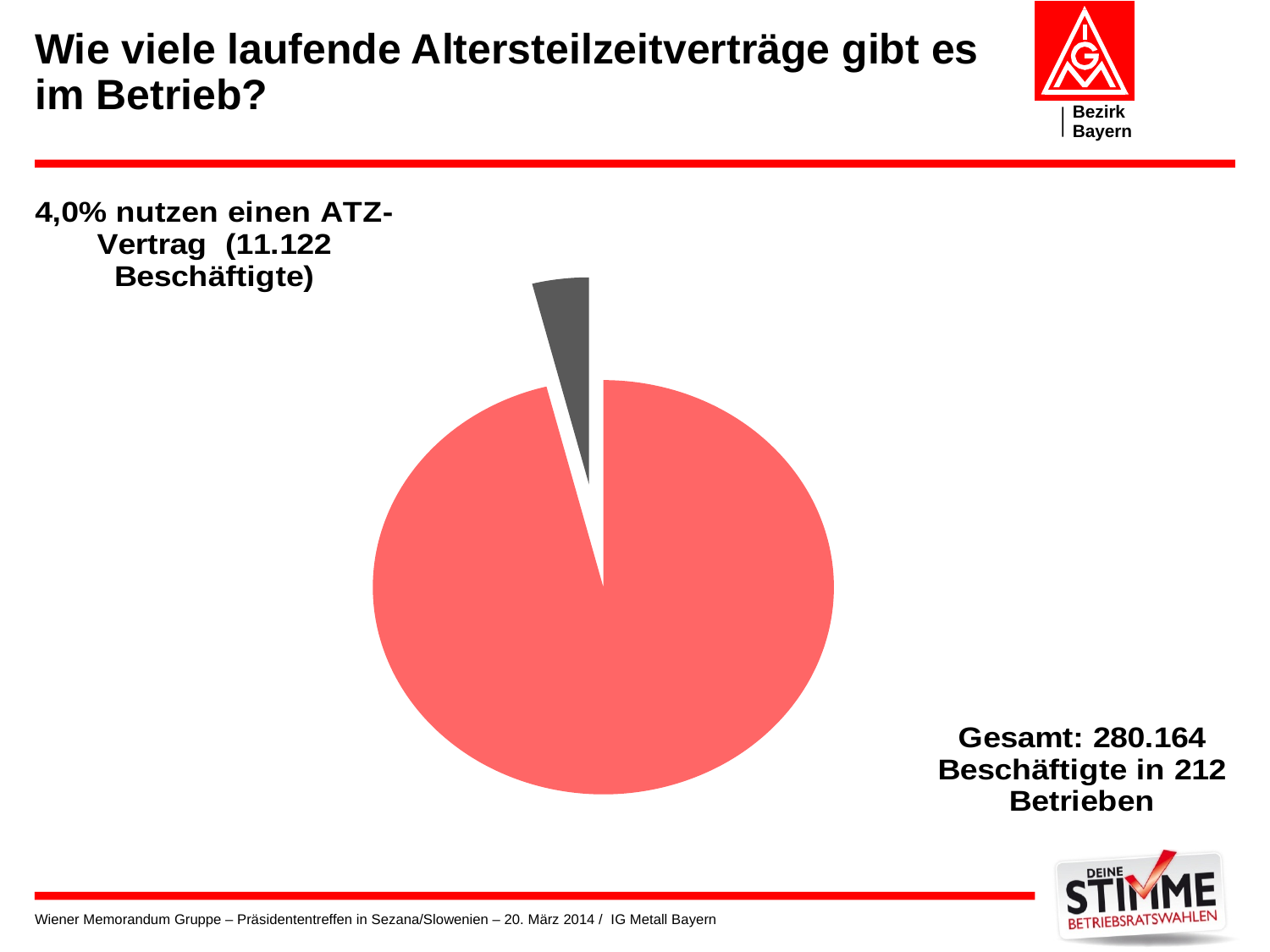
Is the share of employees using an ATZ-Vertrag greater or less than 10%? less What share of employees use an ATZ-Vertrag according to the pie chart? 4,0% What share of employees do not use an ATZ-Vertrag, based on the percentage shown? 96,0% How many employees use an ATZ-Vertrag according to the slide? 11.122 What is the title of the slide containing the pie chart? Wie viele laufende Altersteilzeitverträge gibt es im Betrieb? Which slice is larger: the grey slice or the red slice? the red slice How many employees do not use an ATZ-Vertrag, based on the total and the ATZ figure shown? 269.042 What kind of chart is shown on the slide? pie chart How many slices does the pie chart have? 2 In how many companies (Betrieben) were the employees counted? 212 What colour is the small exploded slice representing employees with an ATZ-Vertrag? grey What is the total number of employees (Gesamt) given on the slide? 280.164